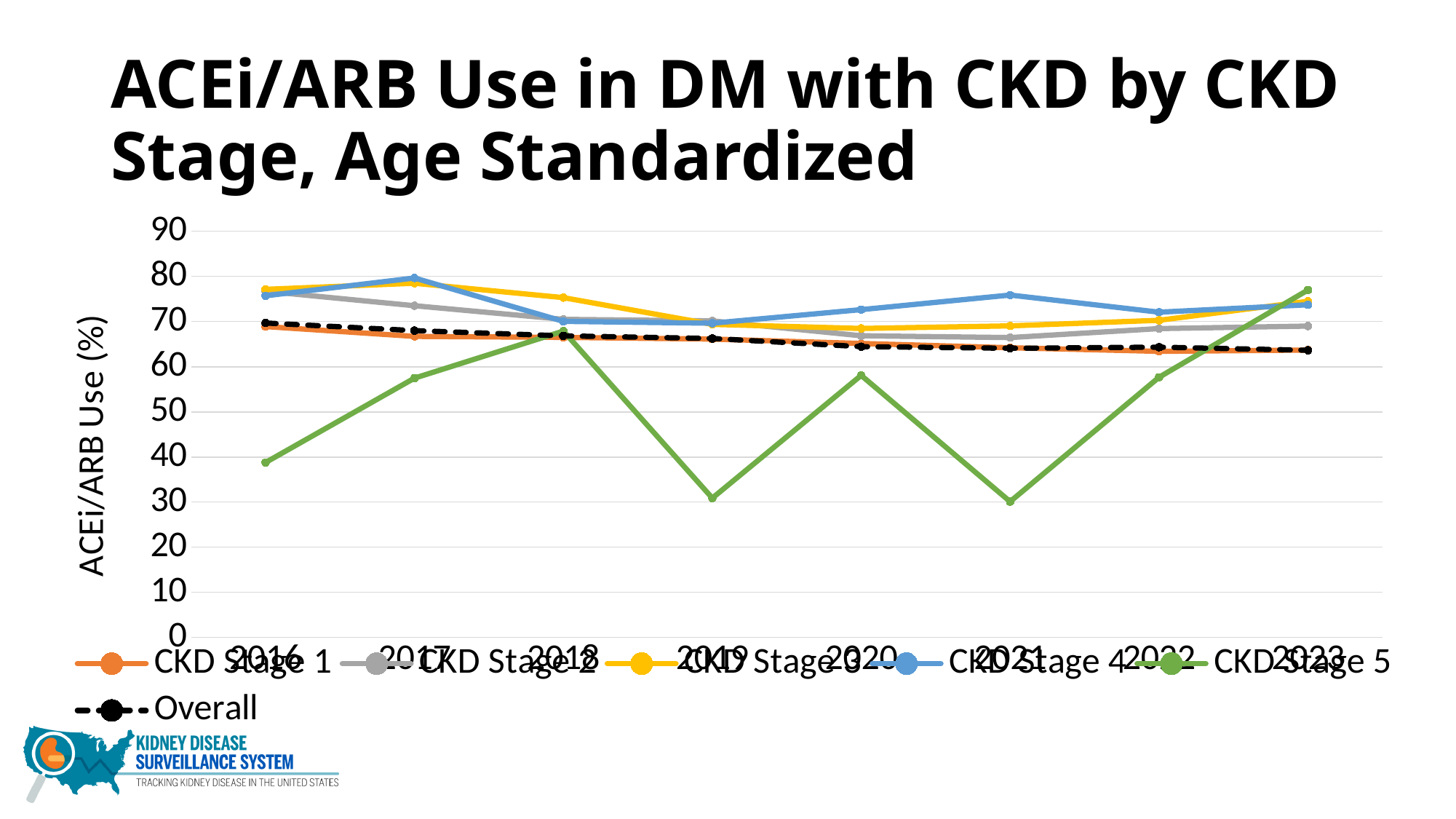
What is the label on the y axis? ACEi/ARB Use (%) In 2021, which is larger: CKD Stage 4 or CKD Stage 5? CKD Stage 4 Is the value for CKD Stage 5 in 2019 greater or less than 40? less Is the value for CKD Stage 4 in 2017 greater or less than 70? greater What kind of chart is shown on the slide? line chart How many years are plotted along the x axis? 8 How many series does the legend list? 6 Is the value for CKD Stage 5 in 2016 greater or less than 50? less Does the Overall line rise or fall from 2016 to 2023? fall Which series has the lowest value in 2019? CKD Stage 5